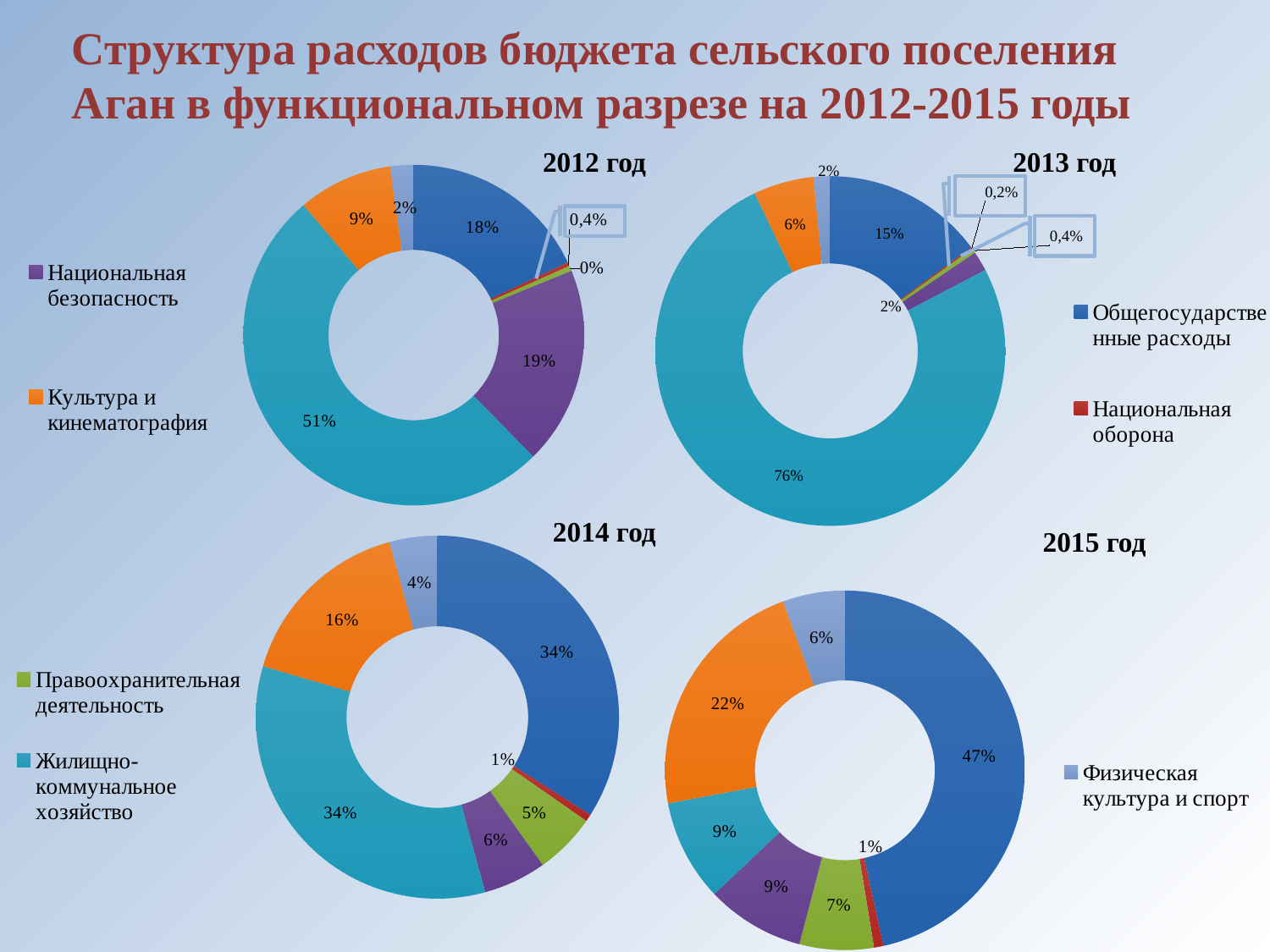
In the 2012 год chart, what share is Жилищно-коммунальное хозяйство? 51% In the 2012 год chart, what share is Национальная безопасность? 19% In the 2015 год chart, what is the difference between the shares of Культура и кинематография and Правоохранительная деятельность? 15% In the 2013 год chart, what share is Общегосударственные расходы? 15% In the 2014 год chart, which is larger: Национальная безопасность or Правоохранительная деятельность? Национальная безопасность In the 2012 год chart, what is the difference between the shares of Жилищно-коммунальное хозяйство and Общегосударственные расходы? 33% In the 2015 год chart, what share is Физическая культура и спорт? 6% In the 2015 год chart, which category has the largest share? Общегосударственные расходы In the 2013 год chart, what share is Жилищно-коммунальное хозяйство? 76% How many doughnut charts are shown on the slide? 4 What kind of chart is used for the 2012 год chart? Doughnut (pie) chart In the 2014 год chart, what share is Культура и кинематография? 16%